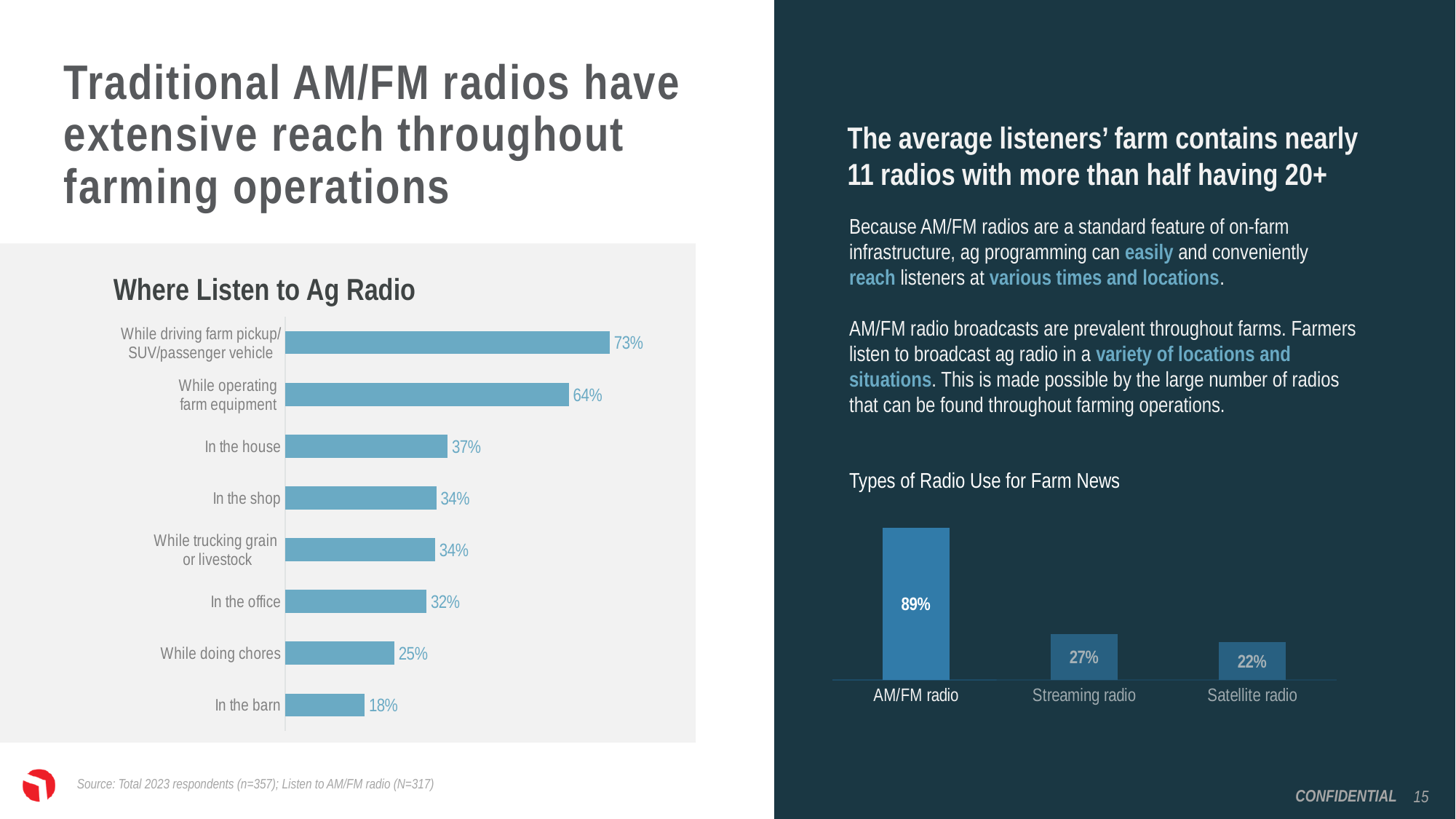
In the 'Types of Radio Use for Farm News' chart, do the values rise or fall from left to right? Fall What type of chart is 'Where Listen to Ag Radio'? Bar chart In the 'Types of Radio Use for Farm News' chart, what is the value for Streaming radio? 27% In the 'Where Listen to Ag Radio' chart, which location has the lowest percentage? In the barn In the 'Where Listen to Ag Radio' chart, what is the difference between 'While operating farm equipment' and 'While doing chores'? 39% In the 'Where Listen to Ag Radio' chart, which is larger: 'In the office' or 'In the shop'? In the shop In the 'Where Listen to Ag Radio' chart, what percentage listen while driving a farm pickup/SUV/passenger vehicle? 73% In the 'Types of Radio Use for Farm News' chart, which type of radio has the highest value? AM/FM radio In the 'Types of Radio Use for Farm News' chart, what is the difference between AM/FM radio and Satellite radio? 67% In the 'Where Listen to Ag Radio' chart, what is the value for 'In the house'? 37% How many categories are shown in the 'Types of Radio Use for Farm News' chart? 3 How many categories are shown in the 'Where Listen to Ag Radio' chart? 8